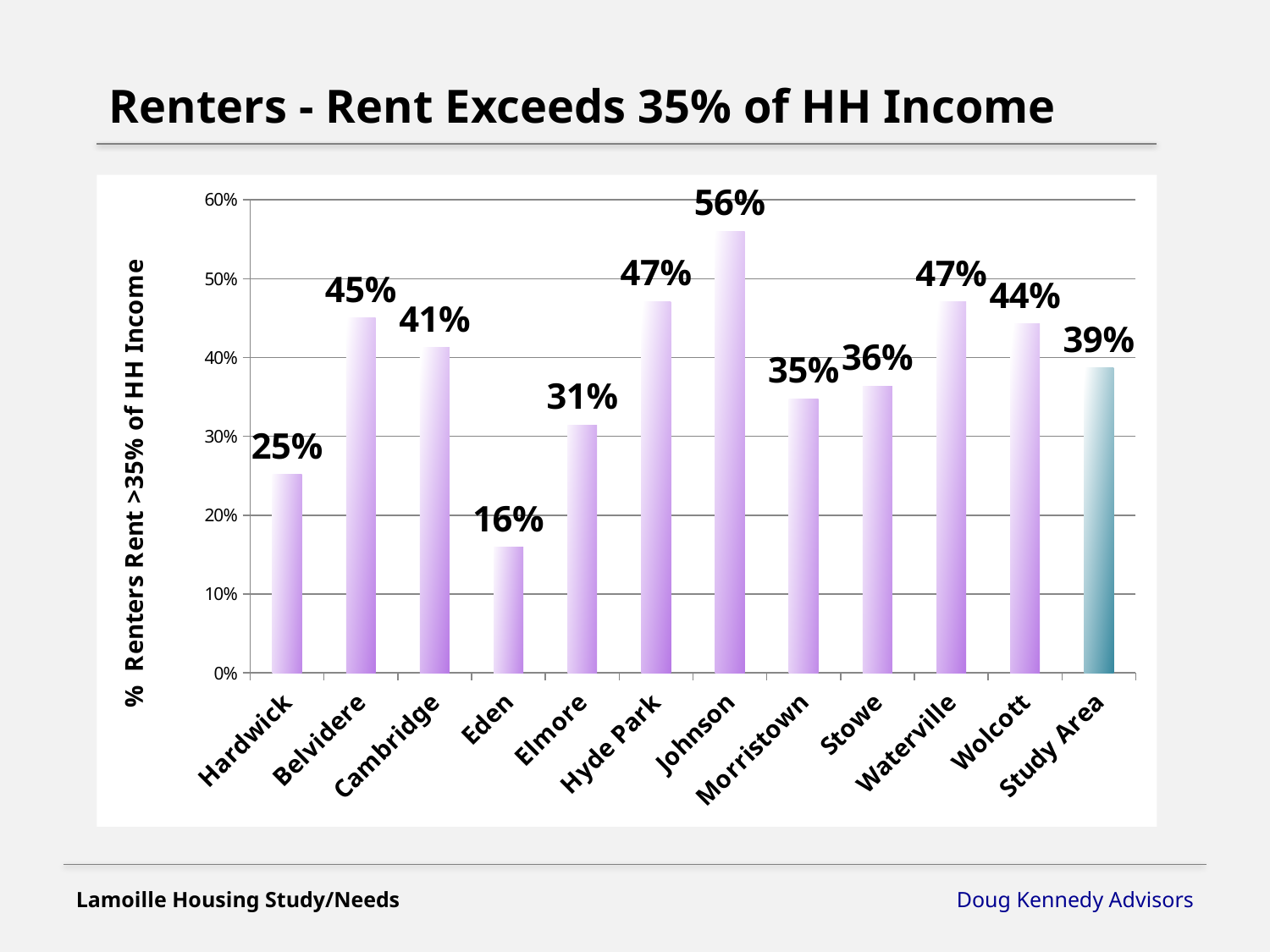
Is the value for Morristown greater or less than 30%? greater How many categories are shown on the x axis? 12 Which has a higher value, Cambridge or Wolcott? Wolcott What percentage of renters in Johnson pay rent exceeding 35% of household income? 56% What is the value shown for the Study Area? 39% What is the title of the slide? Renters - Rent Exceeds 35% of HH Income Which town has the lowest percentage of renters whose rent exceeds 35% of household income? Eden What is the difference between the values for Johnson and Eden? 40% Which town has the highest percentage of renters whose rent exceeds 35% of household income? Johnson What is the difference between the values for Belvidere and Hardwick? 20% What kind of chart is shown on the slide? Bar chart What is the value shown for Eden? 16%